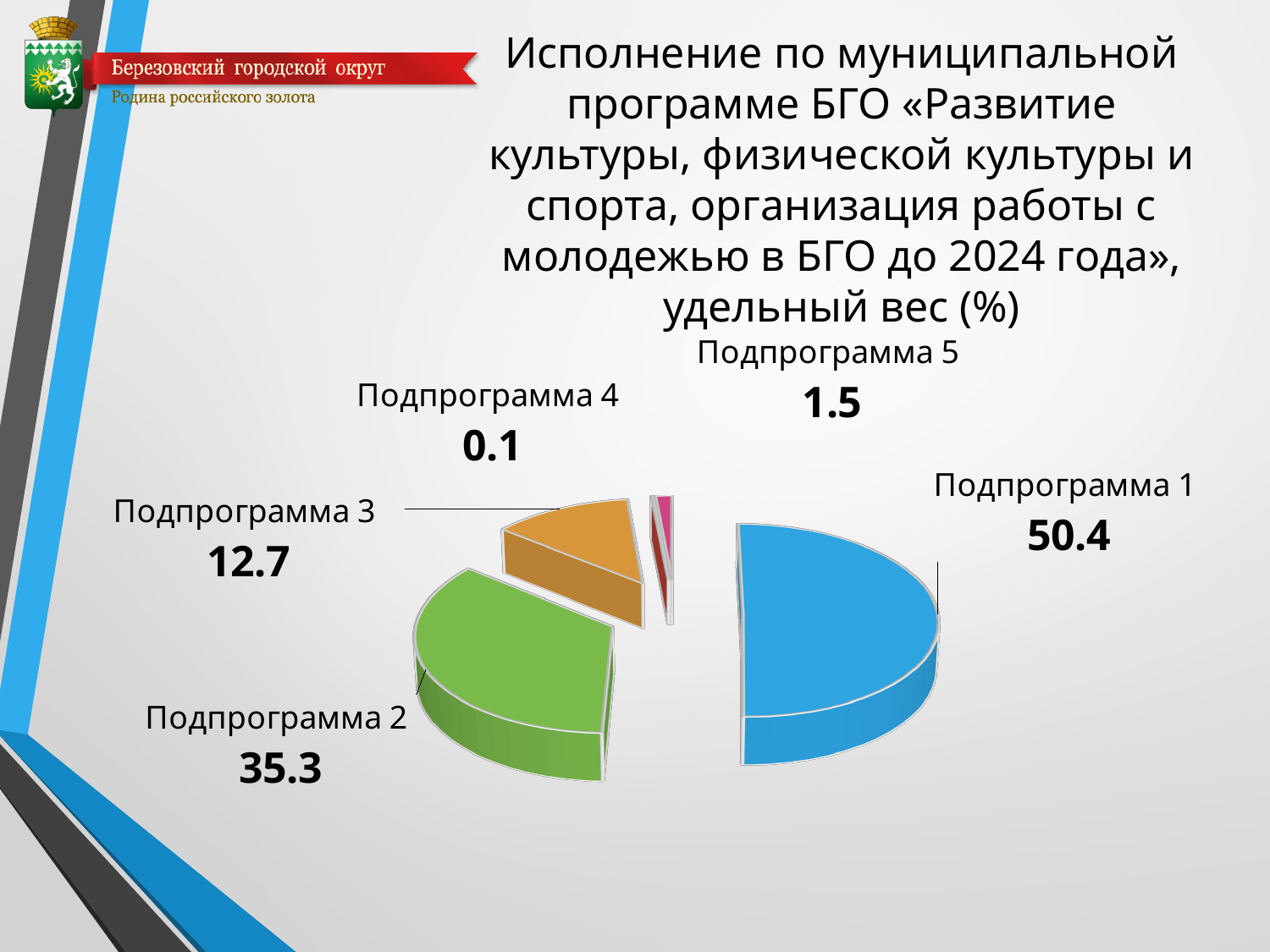
What kind of chart is shown on the slide? Pie chart What is the value shown for Подпрограмма 5? 1.5 Which subprogram has the smallest share of the pie? Подпрограмма 4 What is the value shown for Подпрограмма 2? 35.3 What is the difference between the values for Подпрограмма 2 and Подпрограмма 3? 22.6 What is the value shown for Подпрограмма 3? 12.7 What colour is the slice for Подпрограмма 2? Green How many subprograms (slices) are shown in the pie chart? 5 What is the value shown for Подпрограмма 1? 50.4 Which is larger, the value for Подпрограмма 5 or the value for Подпрограмма 4? Подпрограмма 5 What is the difference between the values for Подпрограмма 1 and Подпрограмма 2? 15.1 Which subprogram has the largest share of the pie? Подпрограмма 1